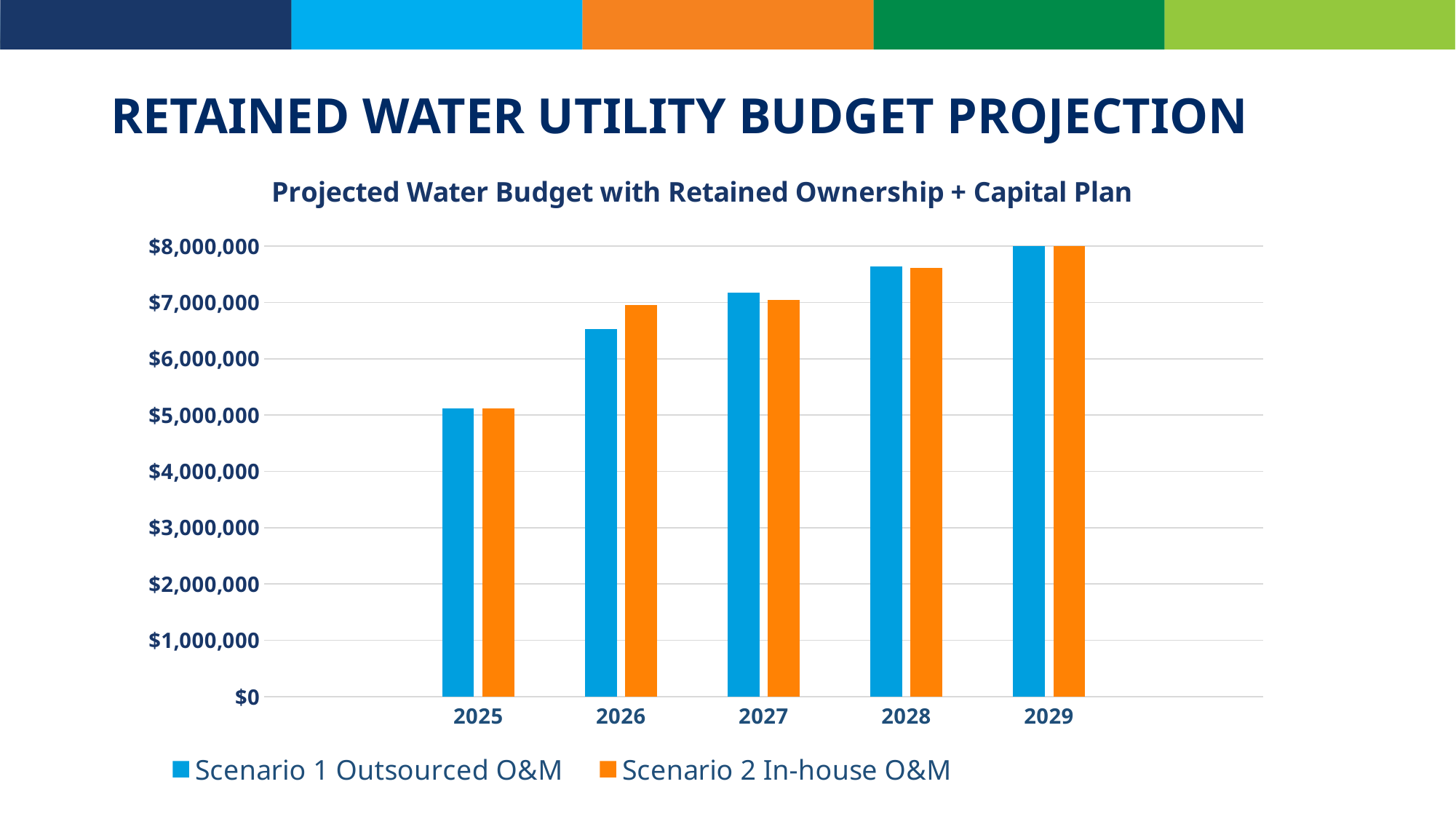
Is the Scenario 1 Outsourced O&M value for 2026 greater or less than $7,000,000? less In 2026, which scenario has the larger value, Scenario 1 Outsourced O&M or Scenario 2 In-house O&M? Scenario 2 In-house O&M Which colour represents Scenario 2 In-house O&M? orange Is the Scenario 2 In-house O&M value for 2028 greater or less than $7,000,000? greater What kind of chart is shown on the slide? bar chart Do the Scenario 1 Outsourced O&M values rise or fall from 2025 to 2029? rise How many years are shown on the x axis? 5 In which year is the Scenario 1 Outsourced O&M value highest? 2029 What is the title of the chart? Projected Water Budget with Retained Ownership + Capital Plan Is the Scenario 1 Outsourced O&M value for 2025 greater or less than $4,000,000? greater How many series does the legend list? 2 In which year is the Scenario 2 In-house O&M value lowest? 2025